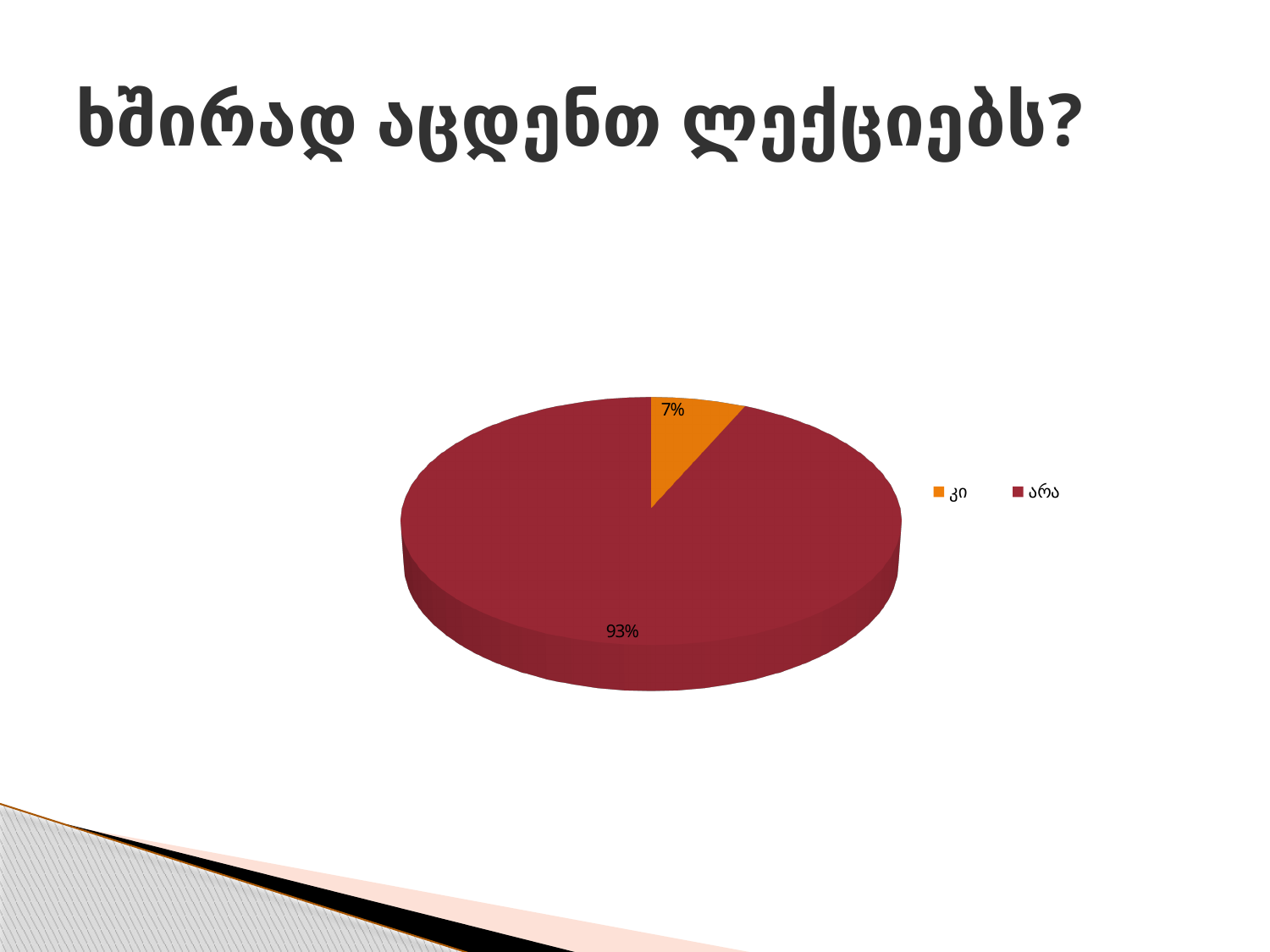
How many slices does the pie chart have? 2 What colour is the "კი" slice in the pie chart? orange How many entries does the legend list? 2 Which category has the largest slice of the pie? არა What is the title of the slide containing the pie chart? ხშირად აცდენთ ლექციებს? What share of the pie does the "არა" slice represent? 93% What kind of chart is shown on the slide? pie chart Which is larger, the "კი" slice or the "არა" slice? არა What share of the pie does the "კი" slice represent? 7% What is the difference in percentage points between the "არა" slice and the "კი" slice? 86 Which category has the smallest slice of the pie? კი